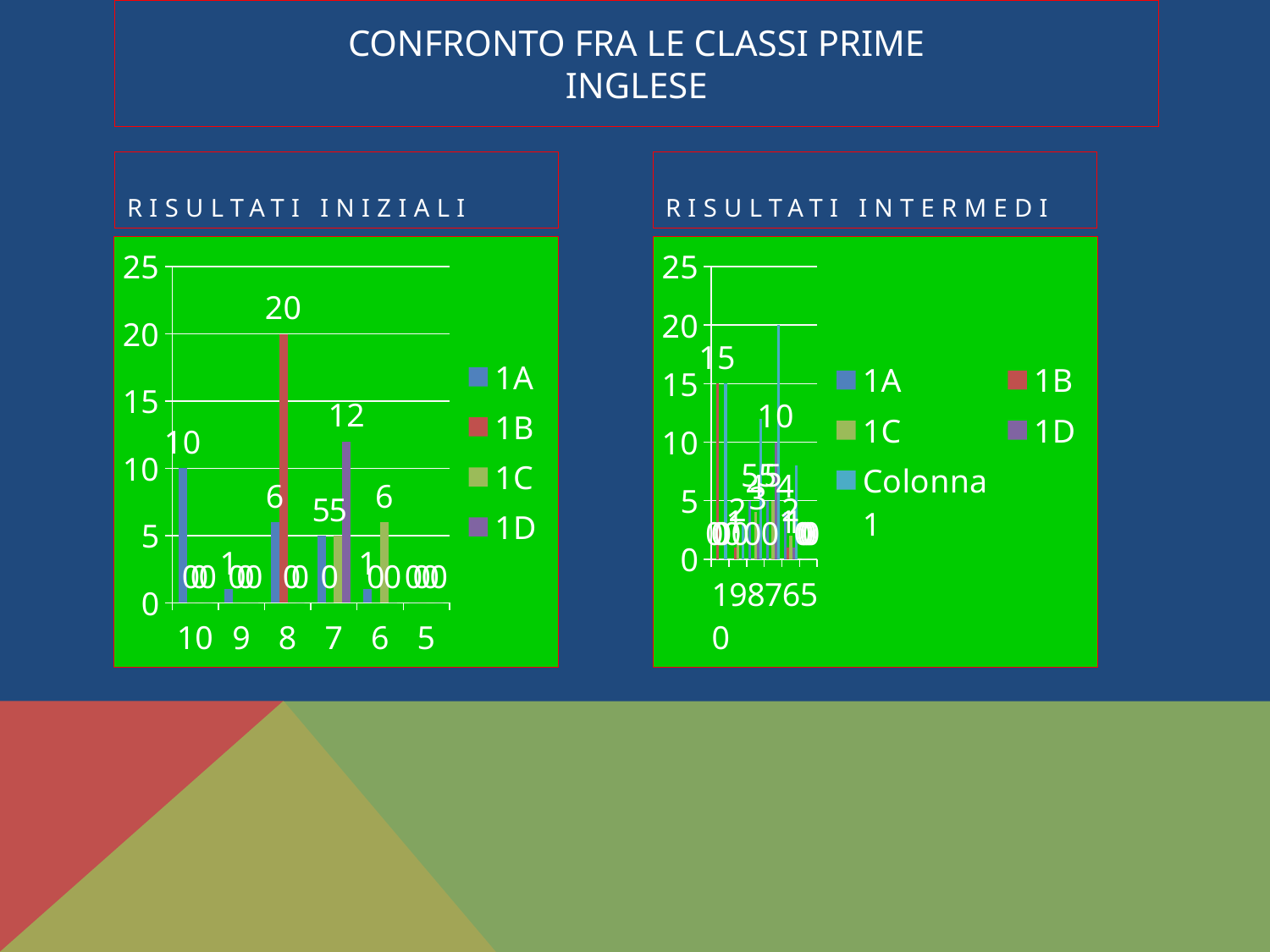
In the RISULTATI INIZIALI chart, which is larger: the value for 1A at category 10 or the value for 1D at category 7? 1D at category 7 In the RISULTATI INIZIALI chart, what is the value for 1D at category 7? 12 In the RISULTATI INIZIALI chart, what is the value for 1B at category 8? 20 In the RISULTATI INIZIALI chart, what is the difference between the value for 1B at category 8 and the value for 1D at category 7? 8 How many series does the legend of the RISULTATI INIZIALI chart list? 4 In the RISULTATI INIZIALI chart, which series has the highest value at category 8? 1B What kind of chart is the RISULTATI INIZIALI chart? Bar chart How many categories are shown on the x axis of the RISULTATI INIZIALI chart? 6 In the RISULTATI INIZIALI chart, what is the value for 1C at category 6? 6 What is the title of the chart on the right side of the slide? RISULTATI INTERMEDI How many series does the legend of the RISULTATI INTERMEDI chart list? 5 In the RISULTATI INIZIALI chart, what is the value for 1A at category 10? 10